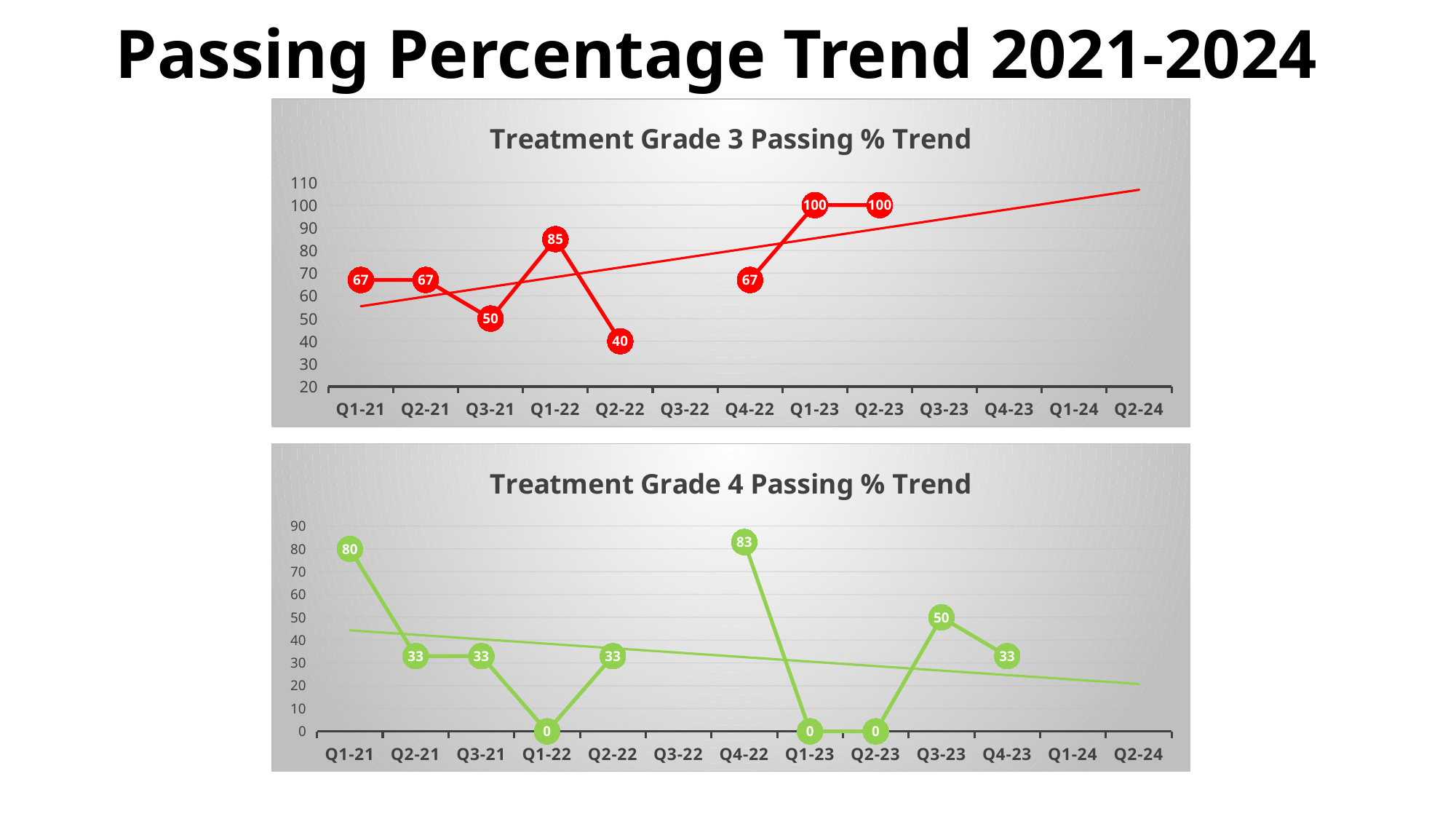
In the Treatment Grade 4 Passing % Trend chart, which quarter has the highest plotted value? Q4-22 In the Treatment Grade 4 Passing % Trend chart, what is the value for Q4-22? 83 In the Treatment Grade 3 Passing % Trend chart, which is larger, the value for Q4-22 or the value for Q1-23? Q1-23 In the Treatment Grade 4 Passing % Trend chart, what is the difference between the values for Q1-21 and Q2-21? 47 In the Treatment Grade 3 Passing % Trend chart, what is the value for Q2-22? 40 In the Treatment Grade 3 Passing % Trend chart, what is the value for Q1-22? 85 In the Treatment Grade 4 Passing % Trend chart, what is the value for Q3-23? 50 What kind of chart is the Treatment Grade 3 Passing % Trend chart? line chart In the Treatment Grade 3 Passing % Trend chart, which quarter has the lowest plotted value? Q2-22 In the Treatment Grade 3 Passing % Trend chart, what is the difference between the values for Q1-22 and Q3-21? 35 In the Treatment Grade 4 Passing % Trend chart, how many quarters have a plotted value of 0? 3 In the Treatment Grade 4 Passing % Trend chart, does the straight trend line rise or fall from left to right? fall